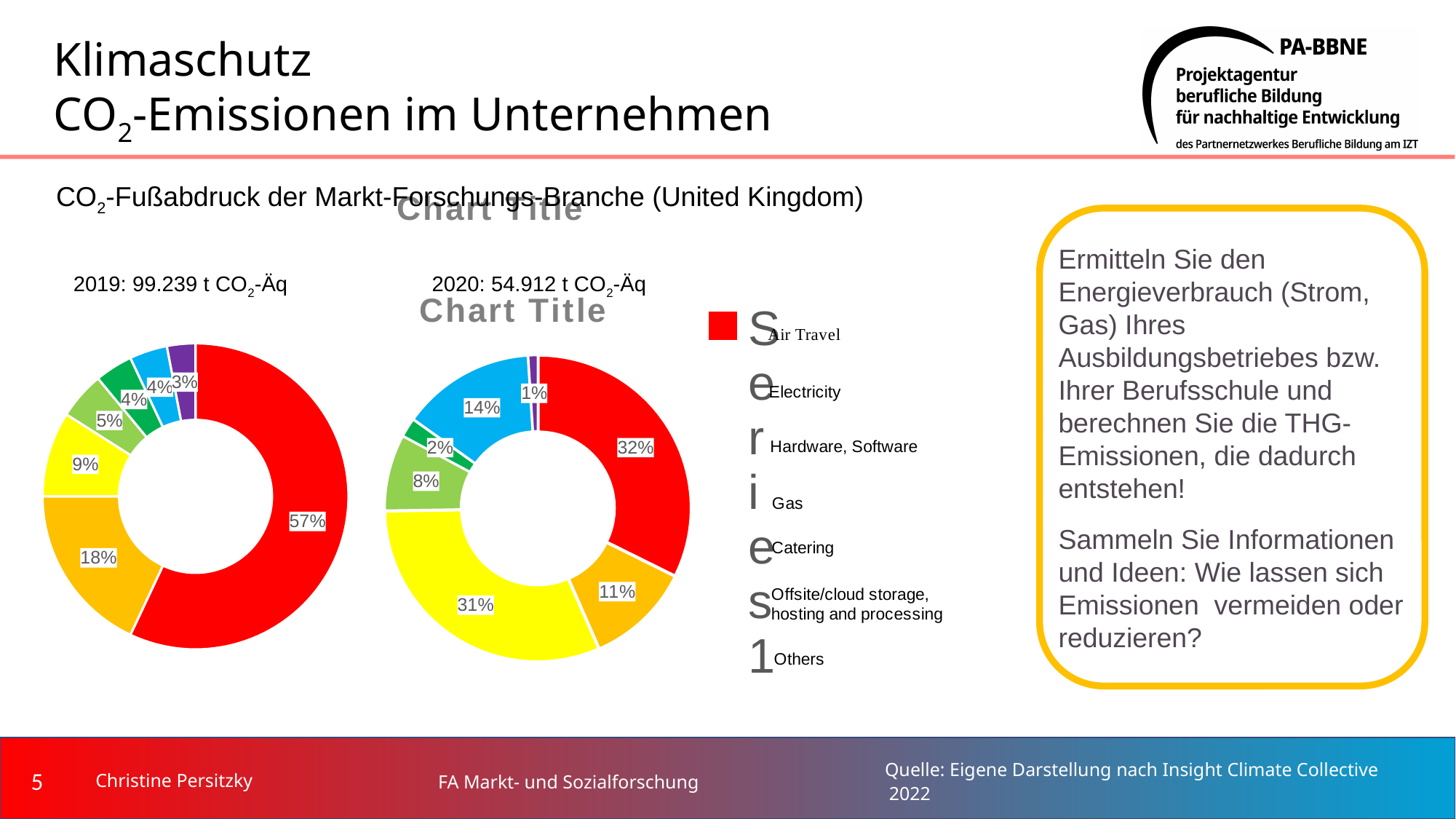
What kind of chart is used to show the 2019 and 2020 CO2 footprints? Doughnut (pie) chart In the 2019 chart, which category has the largest share? Air Travel What total CO2 footprint is given in the label above the 2019 chart? 99.239 t CO2-Äq In the 2020 chart, which slice is larger: the red slice or the yellow slice? The red slice (32%) How many categories does the legend list? 7 In the 2020 chart, what is the smallest percentage shown on any slice? 1% In the 2019 chart, what percentage is shown on the orange slice? 18% In the 2020 chart, what percentage is shown on the blue slice? 14% By how many percentage points did the Air Travel share fall from the 2019 chart to the 2020 chart? 25 percentage points How many slices does the 2019 doughnut chart have? 7 In the 2020 doughnut chart, what percentage is shown for the Air Travel (red) slice? 32% In the 2019 doughnut chart, what percentage is shown for the Air Travel (red) slice? 57%